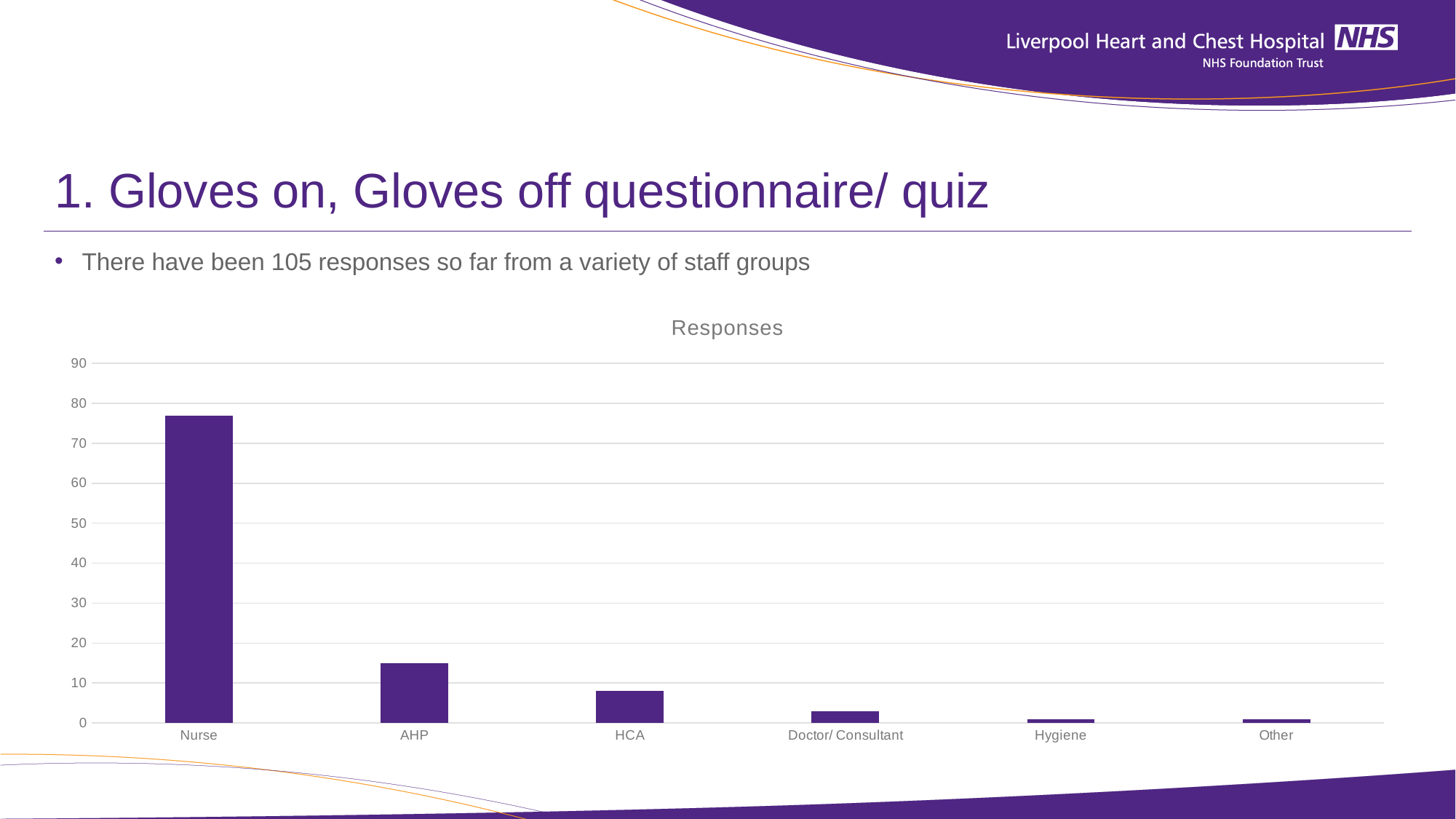
Which has more responses, HCA or Doctor/ Consultant? HCA Is the value for AHP greater or less than 10? greater Which staff group has the highest number of responses? Nurse Is the value for Nurse greater or less than 80? less Do the bar values rise or fall moving from left to right along the x axis? Fall Which has more responses, AHP or HCA? AHP What is the title of the chart? Responses What kind of chart is shown on the slide? Bar chart How many staff group categories are shown on the x axis of the chart? 6 Is the value for HCA greater or less than 10? less